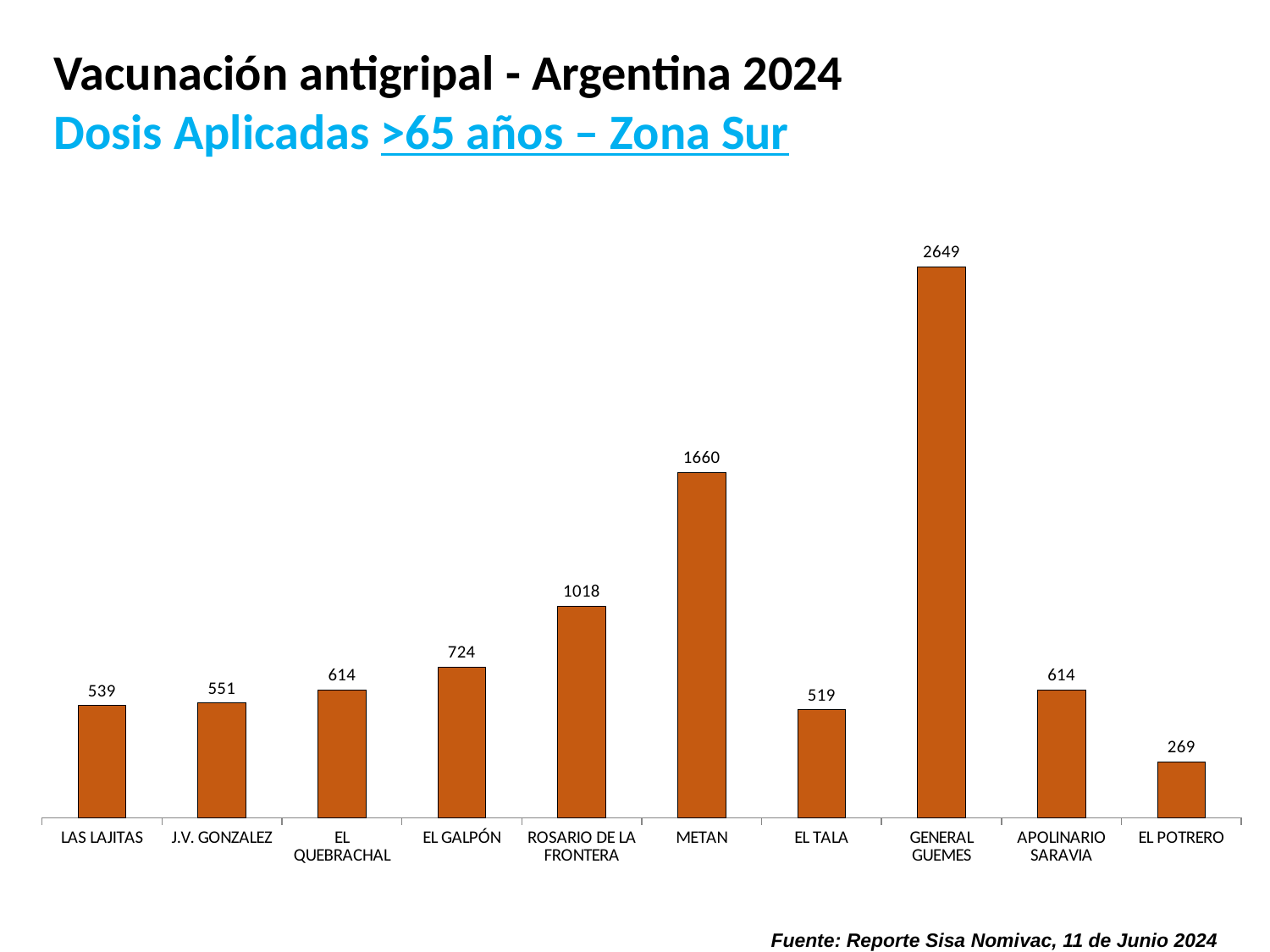
Which category has the highest value? GENERAL GUEMES What kind of chart is shown on the slide? Bar chart How many categories are shown on the x axis? 10 Which category has the lowest value? EL POTRERO What is the value for ROSARIO DE LA FRONTERA? 1018 What is the value for EL POTRERO? 269 What is the value for GENERAL GUEMES? 2649 What source is cited at the bottom of the slide? Reporte Sisa Nomivac, 11 de Junio 2024 What is the difference between the values for GENERAL GUEMES and METAN? 989 Which two categories share the same value of 614? EL QUEBRACHAL and APOLINARIO SARAVIA What is the difference between the values for EL GALPÓN and EL TALA? 205 Which is larger, the value for LAS LAJITAS or the value for J.V. GONZALEZ? J.V. GONZALEZ